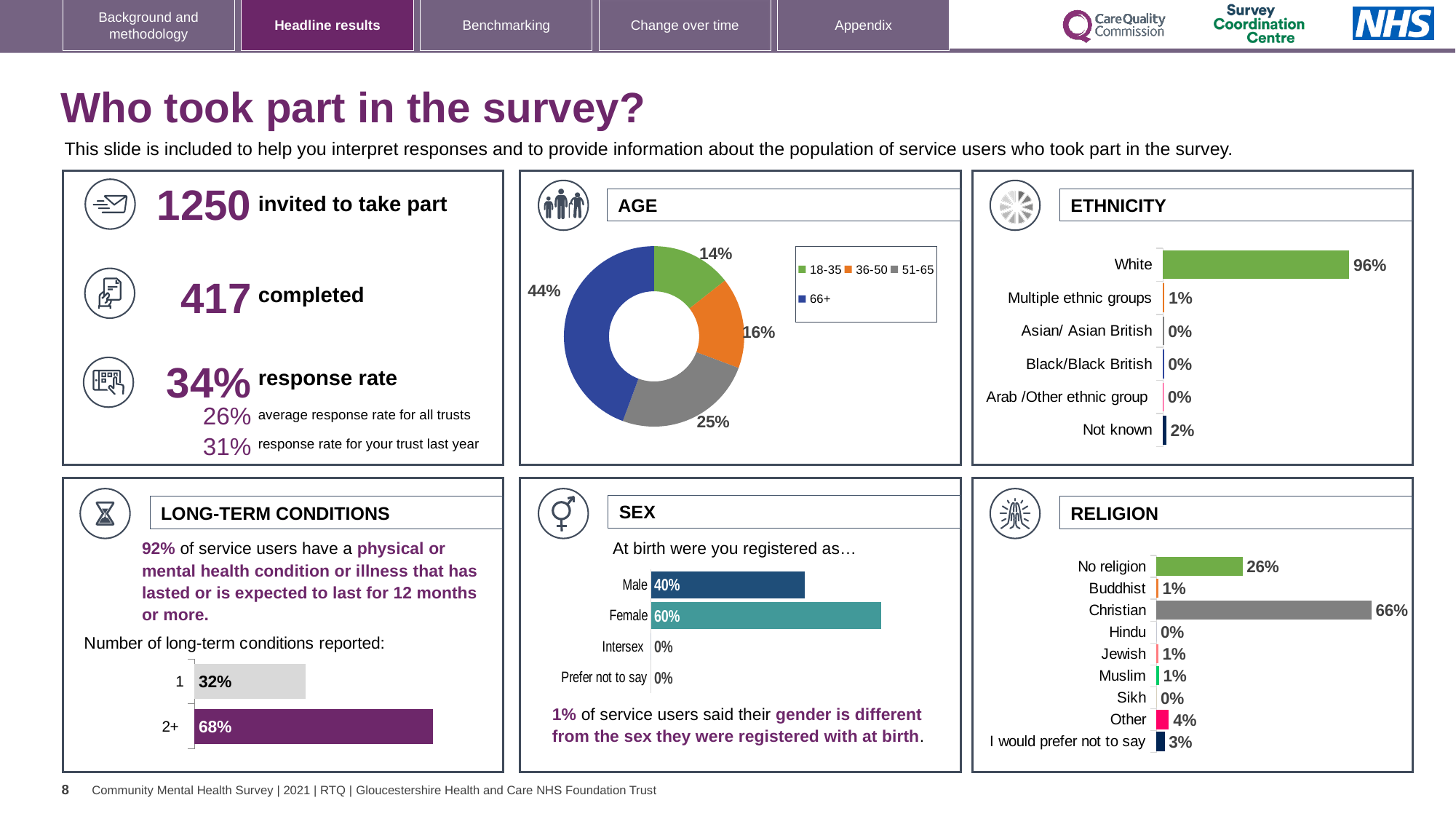
In the ETHNICITY chart, what is the value for White? 96% In the ETHNICITY chart, what is the difference between White and Not known? 94% In the LONG-TERM CONDITIONS chart, what percentage of service users reported 2+ conditions? 68% How many categories are shown in the ETHNICITY chart? 6 How many age groups does the legend of the AGE chart list? 4 In the RELIGION chart, which category has the highest value? Christian In the AGE chart, which age group has the smallest share? 18-35 In the RELIGION chart, what is the value for Other? 4% In the SEX chart, what is the difference between Female and Male? 20% What kind of chart is the AGE chart? Donut chart In the AGE chart, what share of respondents are aged 66+? 44% In the SEX chart, which is larger, Male or Female? Female